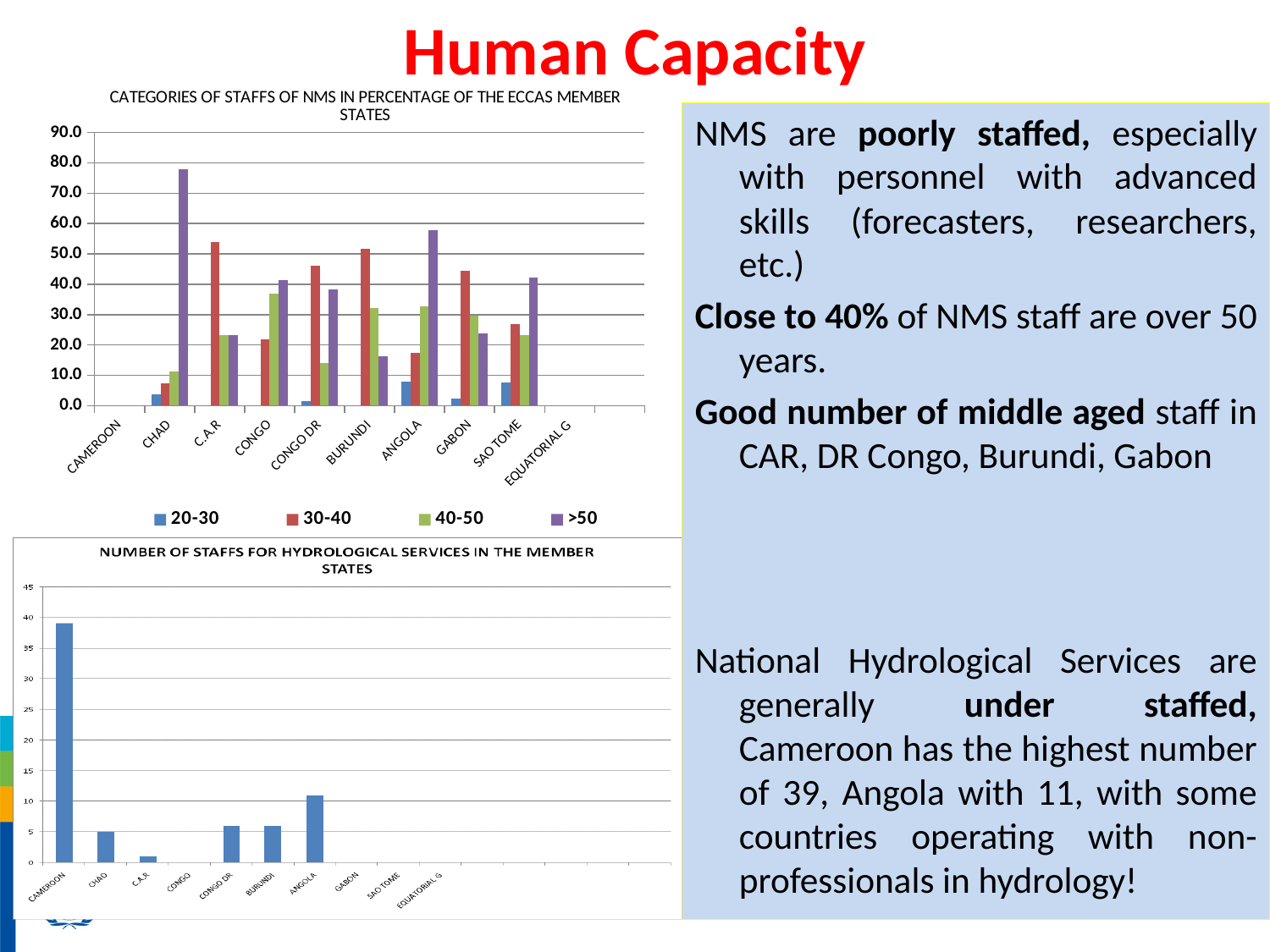
What type of chart is the top chart titled 'CATEGORIES OF STAFFS OF NMS IN PERCENTAGE OF THE ECCAS MEMBER STATES'? Bar chart In the bottom chart (number of staffs for hydrological services), what is the number of staff for CHAD? 5 In the top chart (categories of NMS staff), is the >50 value for CHAD greater or less than 70.0? greater In the top chart (categories of NMS staff), which age series has the tallest bar for CHAD? >50 In the top chart (categories of NMS staff), is the 40-50 value for CONGO greater or less than 40.0? less In the top chart (categories of NMS staff), is the >50 value for ANGOLA greater or less than 50.0? greater In the bottom chart (number of staffs for hydrological services), which is larger: the value for ANGOLA or the value for CHAD? ANGOLA In the bottom chart (number of staffs for hydrological services), which country has the highest number of staff? CAMEROON How many series does the legend of the top chart (categories of NMS staff) list? 4 In the top chart (categories of NMS staff), which country has the tallest bar overall? CHAD In the top chart (categories of NMS staff), which is larger for GABON: the 30-40 bar or the 40-50 bar? 30-40 How many countries are shown on the x axis of the bottom chart (number of staffs for hydrological services)? 10